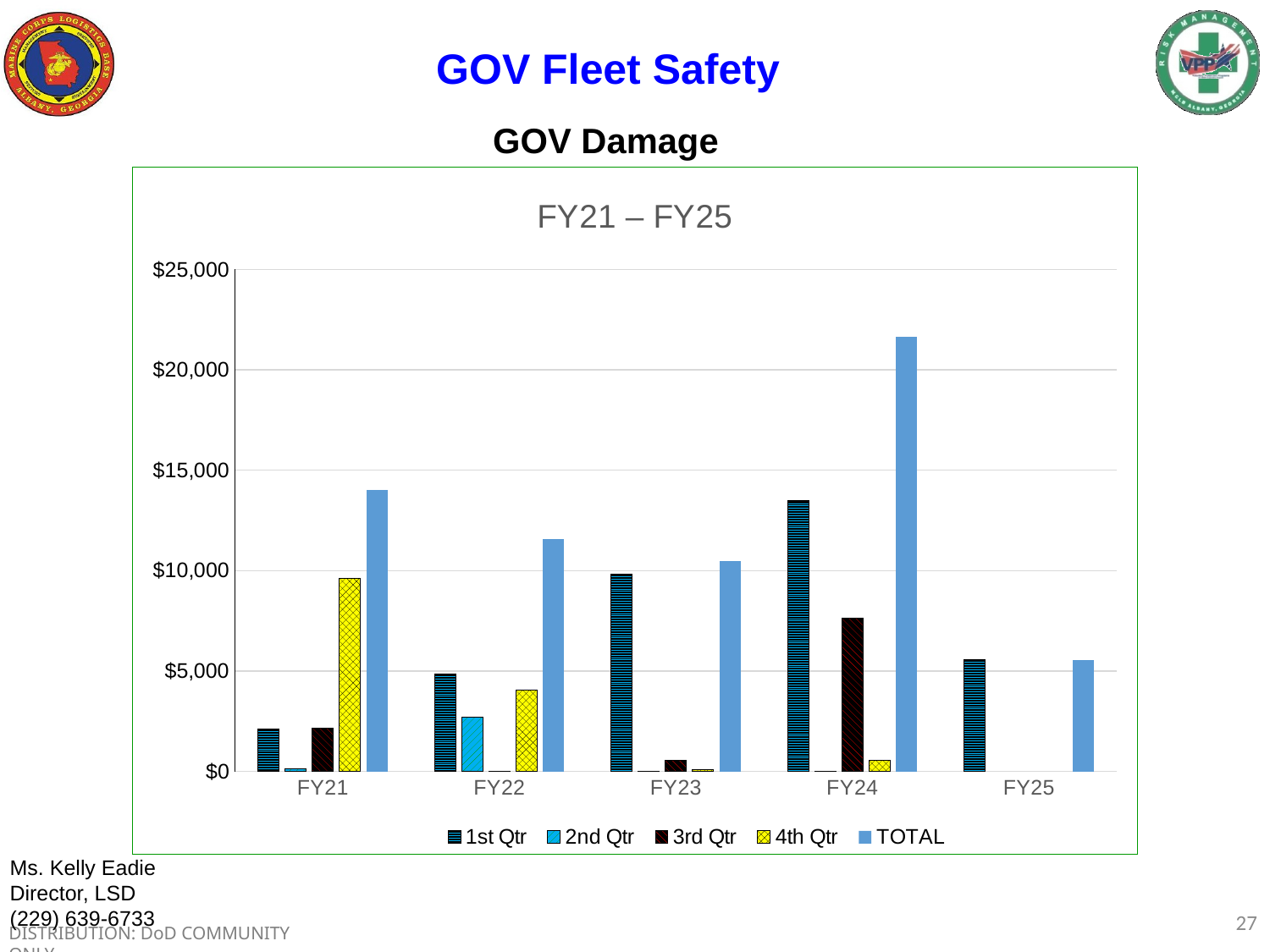
How many fiscal years are shown on the x axis? 5 In FY24, which is larger, the 1st Qtr value or the 3rd Qtr value? 1st Qtr Which is larger, the 1st Qtr value for FY23 or the 1st Qtr value for FY22? FY23 Is the 4th Qtr value for FY21 greater or less than $5,000? greater Which fiscal year has the highest TOTAL bar? FY24 What is the title shown inside the chart area? FY21 – FY25 In FY21, which quarter has the highest bar? 4th Qtr Which fiscal year has the lowest TOTAL bar? FY25 How many series does the legend list? 5 What kind of chart is shown on the slide? bar chart Is the TOTAL value for FY25 greater or less than $10,000? less Is the TOTAL value for FY24 greater or less than $20,000? greater